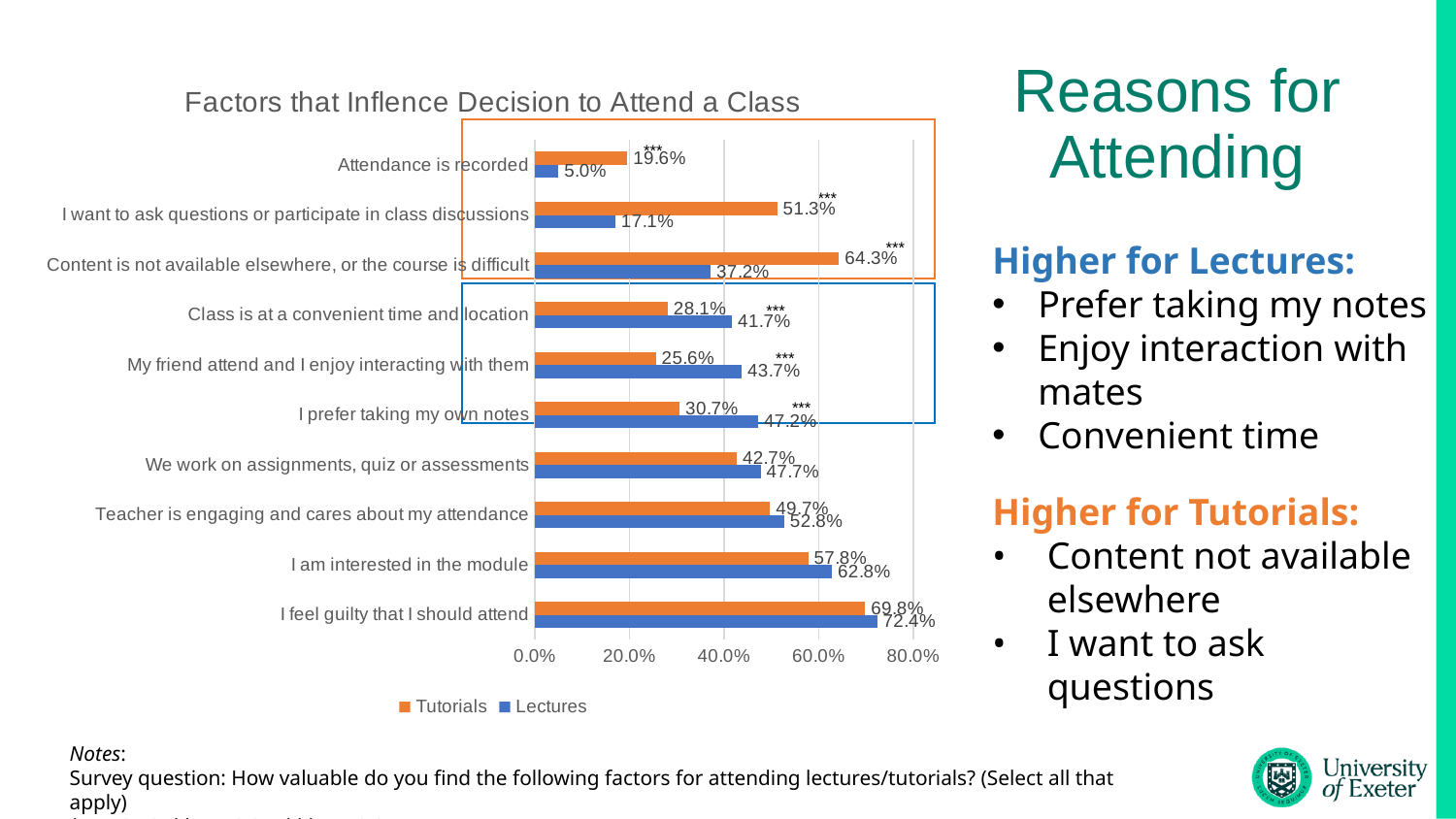
How many series does the legend list? 2 Which colour represents the Tutorials series in the chart? Orange What is the Lectures value for 'I prefer taking my own notes'? 47.2% What kind of chart is shown on the slide? Bar chart How many factors (categories) are plotted in the chart? 10 What is the Lectures value for 'Attendance is recorded'? 5.0% For 'My friend attend and I enjoy interacting with them', which series has the larger value, Tutorials or Lectures? Lectures Is the Tutorials value for 'I feel guilty that I should attend' greater or less than 60.0%? greater What is the difference between the Tutorials and Lectures values for 'I want to ask questions or participate in class discussions'? 34.2% Which factor has the lowest Tutorials value? Attendance is recorded Which factor has the highest Lectures value? I feel guilty that I should attend What is the Tutorials value for 'Content is not available elsewhere, or the course is difficult'? 64.3%